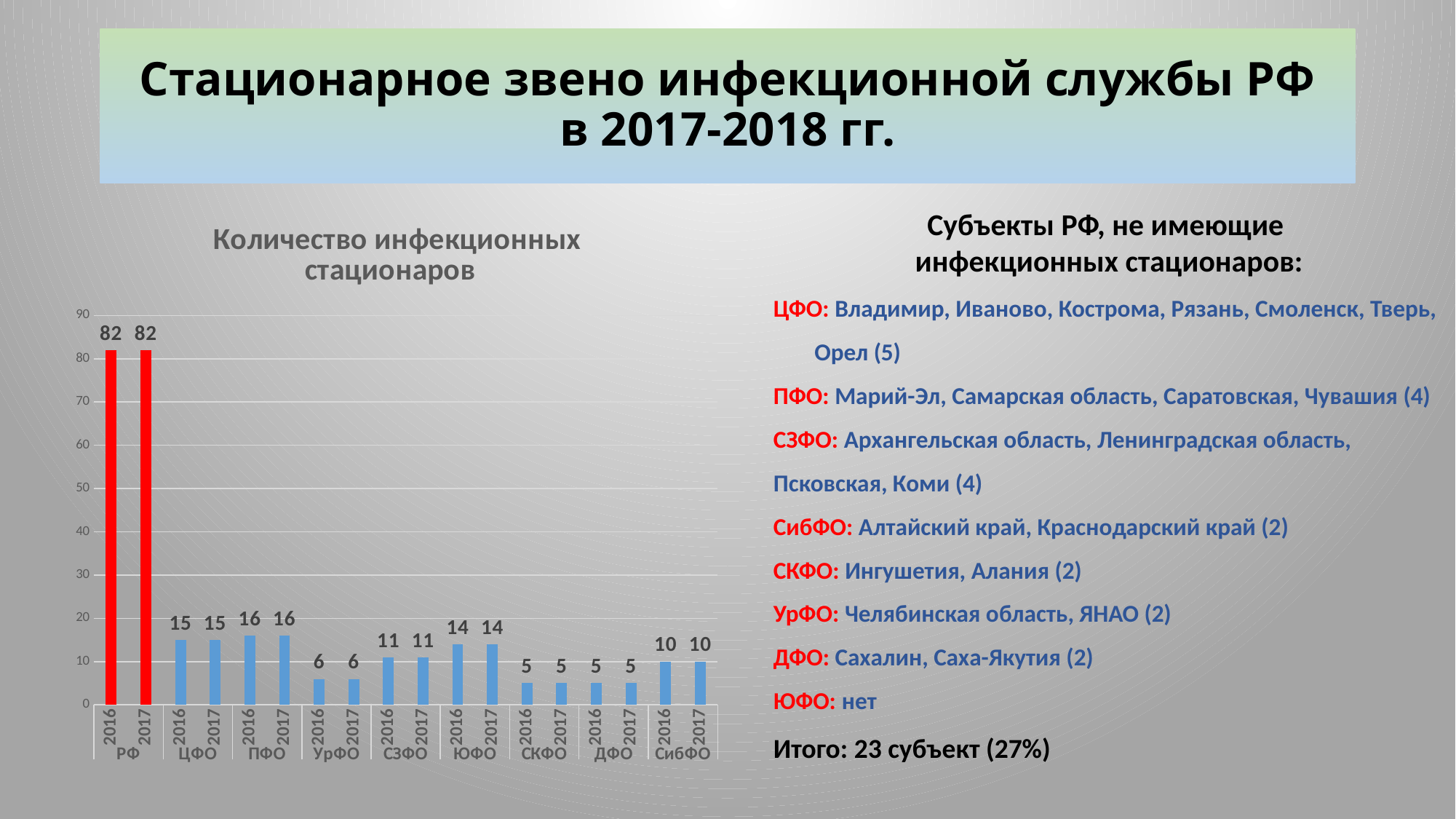
What type of chart is shown on the slide? bar chart What is the value for УрФО in 2017 in the chart? 6 What is the value for ПФО in 2016 in the chart? 16 What is the value for СибФО in 2016 in the chart? 10 Does the value for ЦФО change from 2016 to 2017 in the chart? No, it stays at 15 What is the difference between the 2016 values for ЦФО and УрФО in the chart? 9 What is the title of the chart on the slide? Количество инфекционных стационаров Excluding РФ, which federal district has the highest value in 2017 in the chart? ПФО Which is larger in 2017 in the chart: СЗФО or ЮФО? ЮФО Which region group has the highest values in the chart? РФ What is the value for РФ in 2017 in the chart? 82 How many region groups are shown on the x axis of the chart? 9